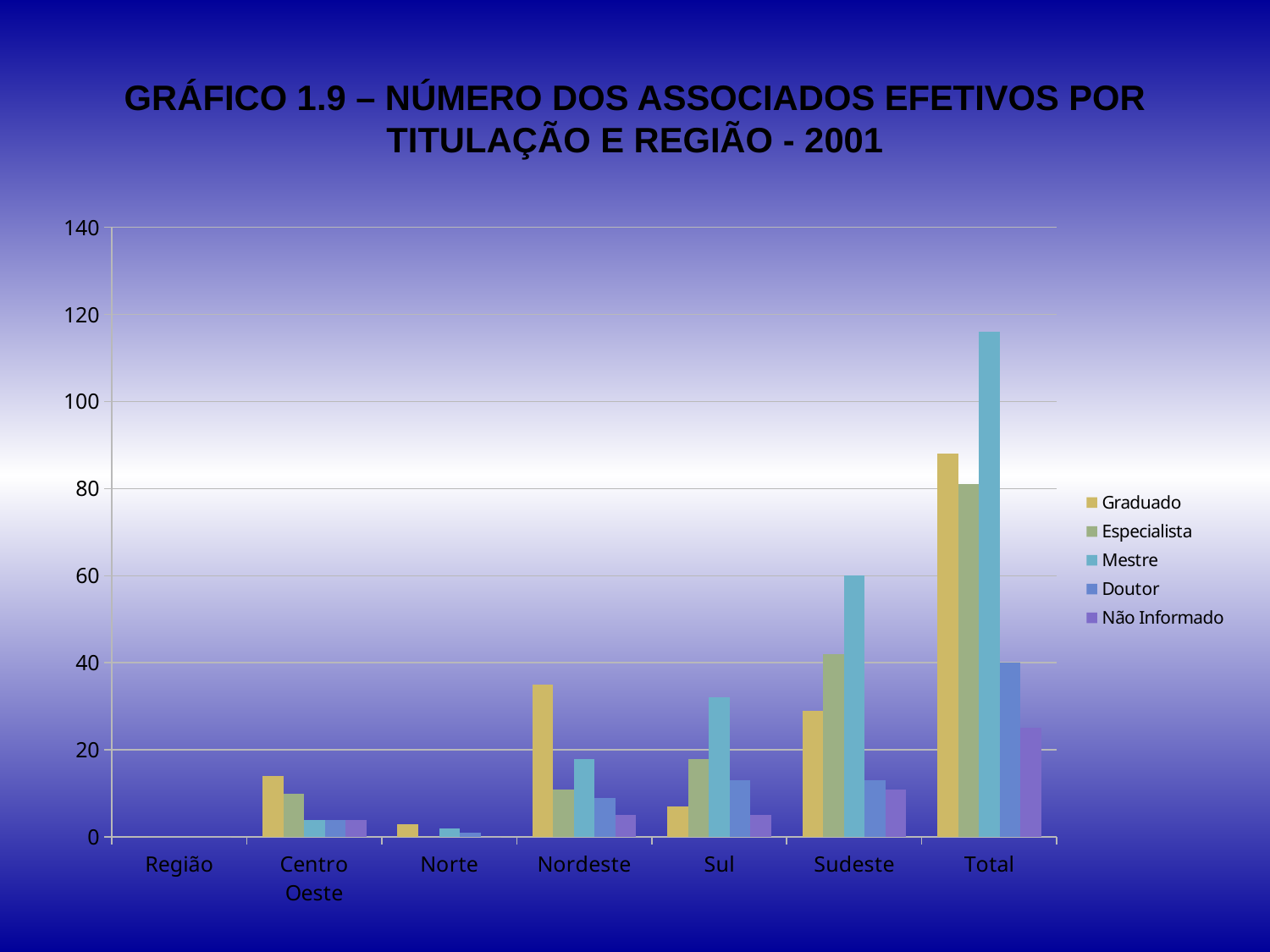
Is the value for Mestre in the Sul category greater or less than 40? less In the Total category, which series has the highest bar? Mestre What is the first entry listed in the legend? Graduado Is the value for Mestre in the Total category greater or less than 100? greater Which is larger: Graduado in Nordeste or Graduado in Sul? Nordeste Is the value for Graduado in the Nordeste category greater or less than 20? greater How many categories are labelled along the x axis? 7 In the Sudeste category, which is larger: Mestre or Graduado? Mestre What kind of chart is shown on the slide? bar chart Among the regions Centro Oeste, Norte, Nordeste, Sul and Sudeste, which has the tallest Mestre bar? Sudeste How many series does the legend list? 5